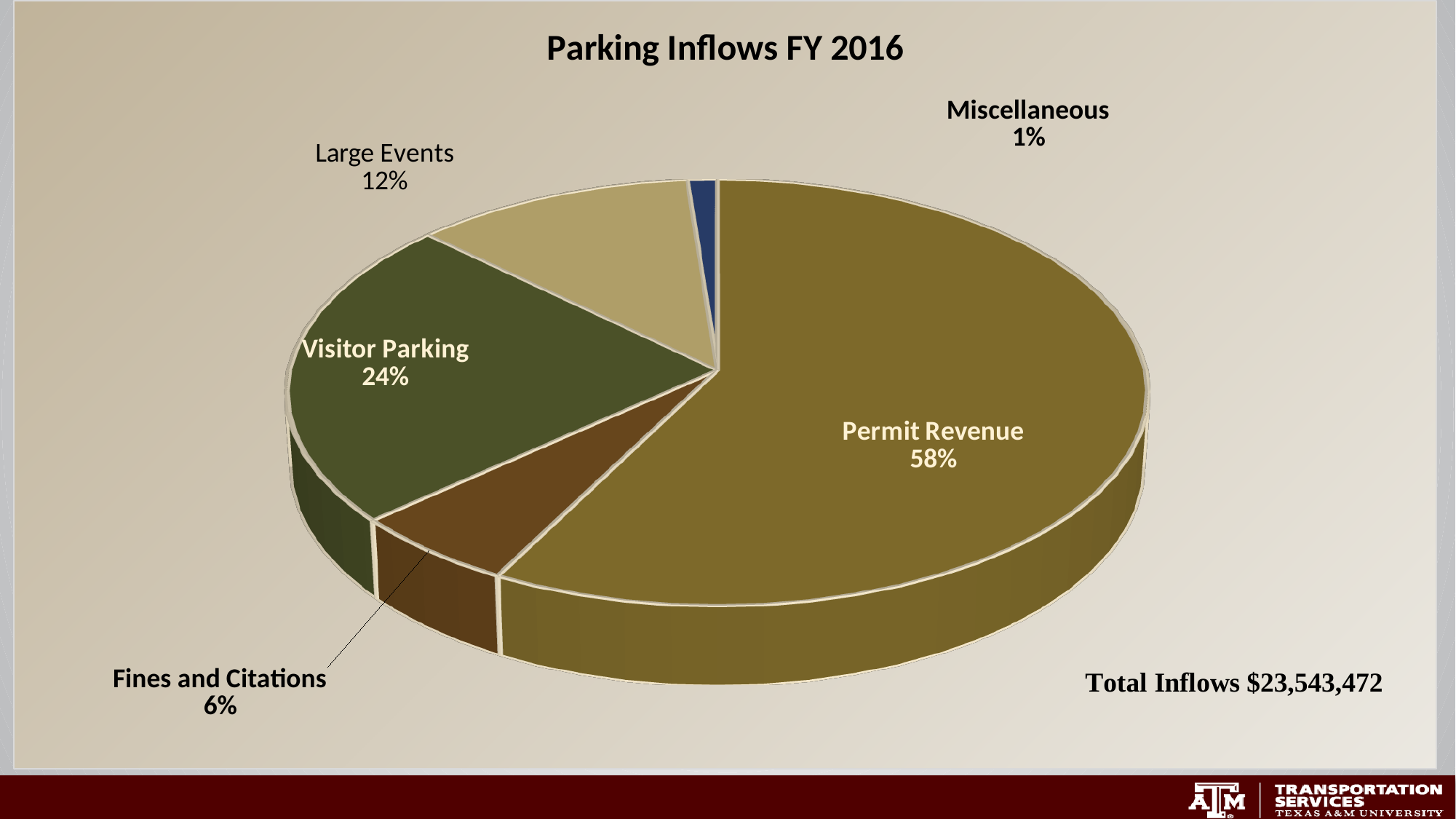
How many categories are shown in the pie chart? 5 What is the title of the chart? Parking Inflows FY 2016 What kind of chart is shown on the slide? Pie chart What percentage is shown for Miscellaneous? 1% What share of parking inflows comes from Permit Revenue? 58% What percentage is shown for Fines and Citations? 6% Which category has the smallest share of parking inflows? Miscellaneous How many percentage points larger is Permit Revenue's share than Visitor Parking's share? 34 What percentage is shown for Large Events? 12% What share of parking inflows comes from Visitor Parking? 24% Which category has the largest share of parking inflows? Permit Revenue Which has a larger share, Large Events or Fines and Citations? Large Events